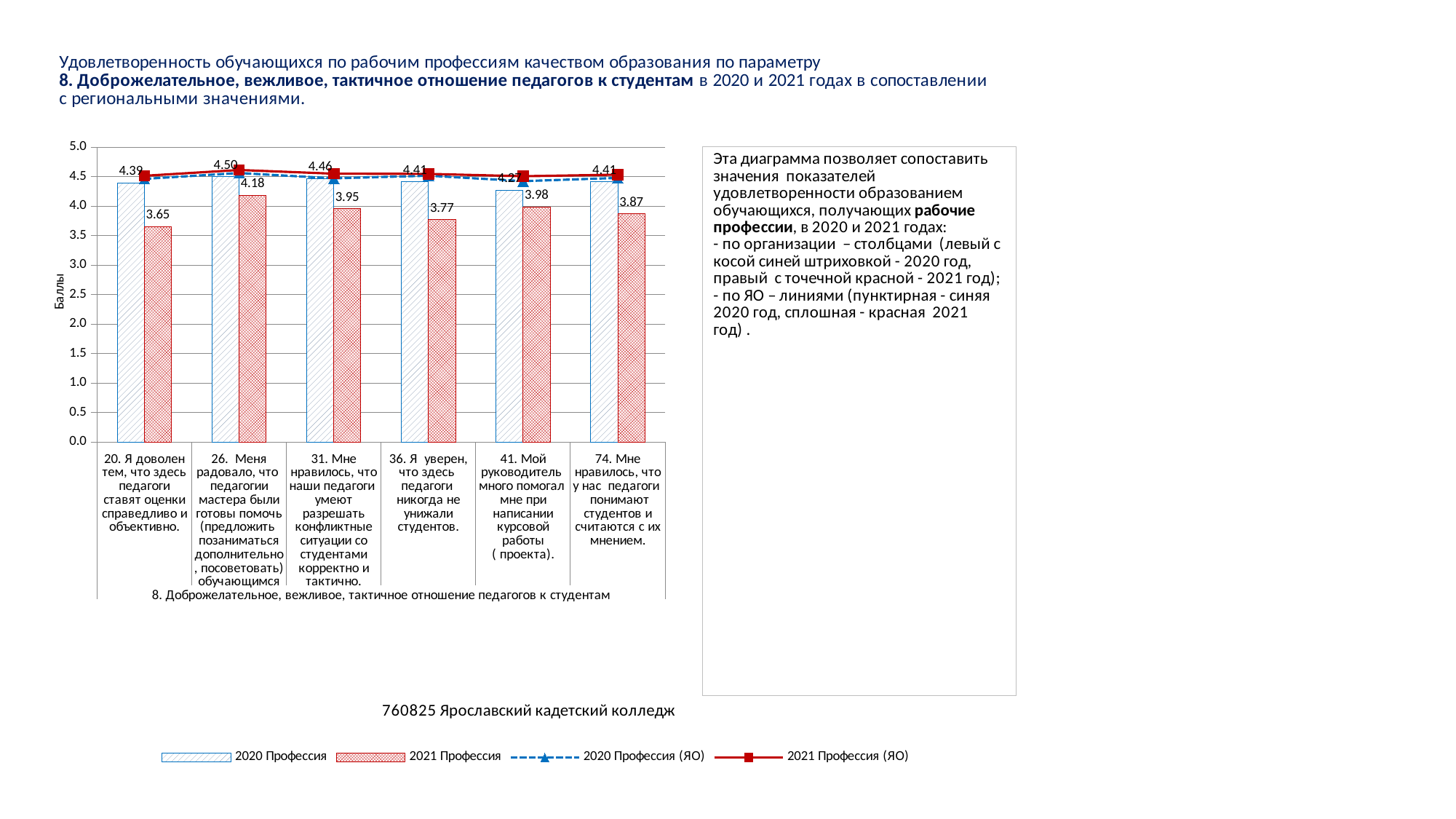
What is the value of the 2021 Профессия bar for category 41 (Мой руководитель много помогал мне при написании курсовой работы)? 3.98 Which category has the lowest 2020 Профессия value? 41. Мой руководитель много помогал мне при написании курсовой работы What is the value of the 2021 Профессия bar for category 26 (Меня радовало, что педагогии мастера были готовы помочь)? 4.18 Which is larger for category 36: the 2020 Профессия value or the 2021 Профессия value? 2020 Профессия How many categories (questions) are shown on the x axis? 6 What is the label of the vertical axis? Баллы How many series does the legend list? 4 What is the value of the 2020 Профессия bar for category 20 (Я доволен тем, что здесь педагоги ставят оценки справедливо и объективно)? 4.39 Is the 2021 Профессия value for category 31 greater or less than 4.0? less What is the difference between the 2020 Профессия and 2021 Профессия values for category 20? 0.74 Which category has the highest 2021 Профессия value? 26. Меня радовало, что педагогии мастера были готовы помочь Which category has the lowest 2021 Профессия value? 20. Я доволен тем, что здесь педагоги ставят оценки справедливо и объективно